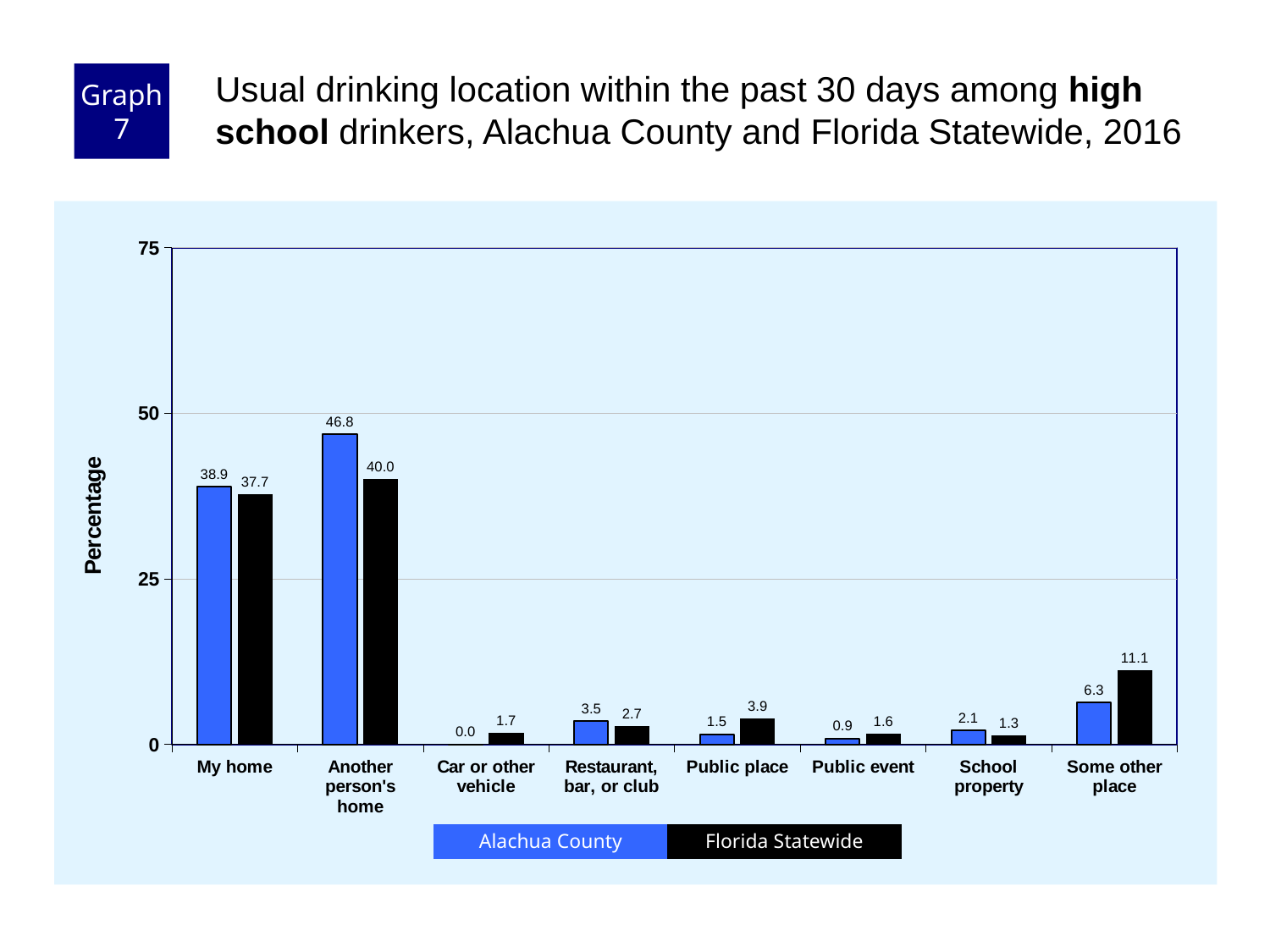
What is the Alachua County value for "Car or other vehicle"? 0.0 Is the Florida Statewide value for "My home" greater or less than 25? greater How many series does the legend list? 2 How many location categories are shown on the x axis? 8 What kind of chart is shown on the slide? Bar chart Which category has the lowest Florida Statewide value? School property For "Public place", which is larger: Alachua County or Florida Statewide? Florida Statewide What is the Florida Statewide value for "Some other place"? 11.1 What is the difference between the Alachua County and Florida Statewide values for "Another person's home"? 6.8 What is the Alachua County value for "My home"? 38.9 What is the label of the y axis? Percentage Which category has the highest Alachua County value? Another person's home